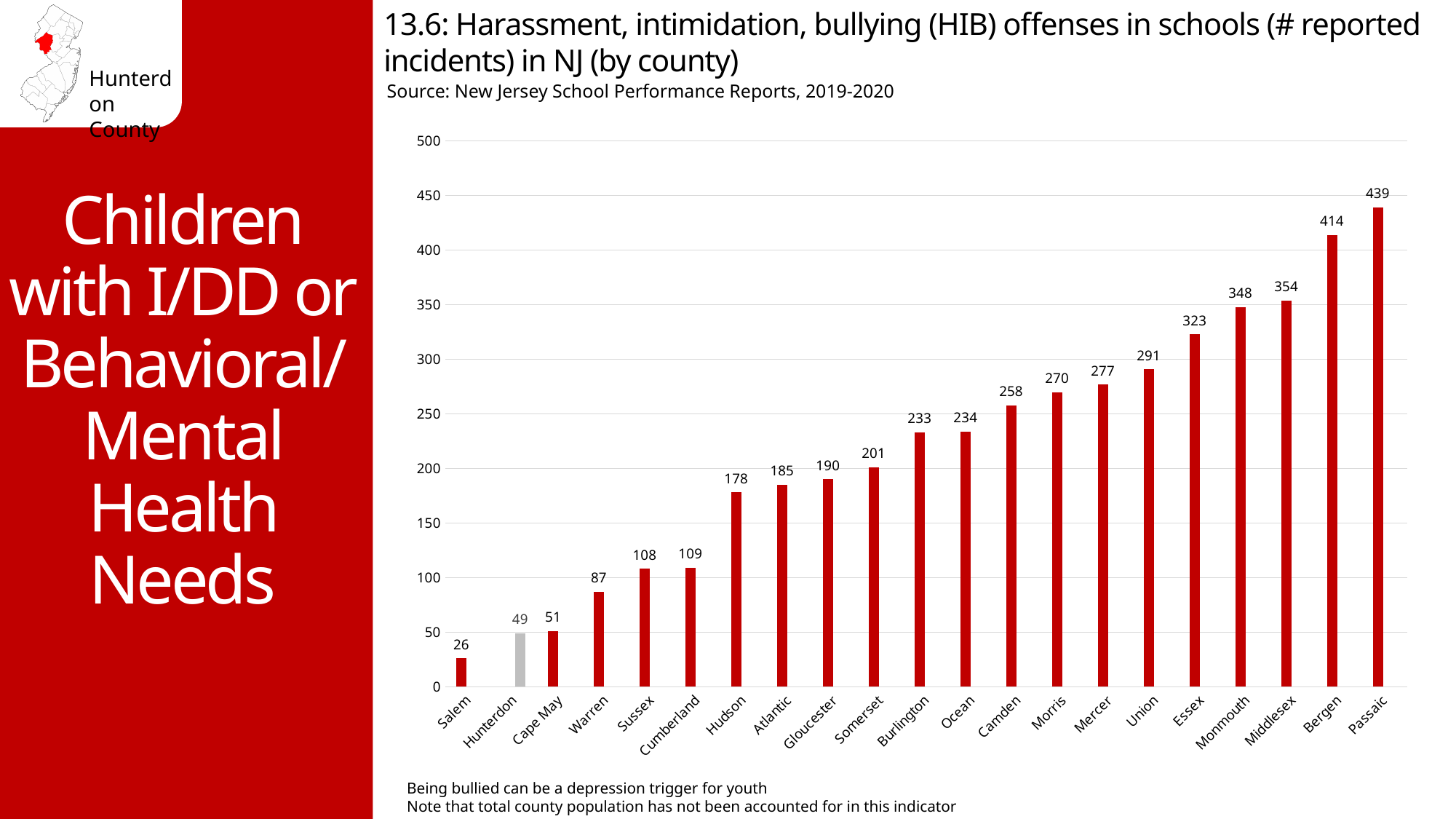
Do the values rise or fall moving from left to right along the x axis? Rise What is the difference between the values for Passaic and Salem? 413 What is the value shown for Gloucester? 190 Is the value for Monmouth greater or less than 300? greater How many counties are shown on the x axis? 21 What is the value shown for Bergen? 414 Which county has the highest number of reported HIB incidents? Passaic How many reported HIB incidents does the chart show for Hunterdon? 49 What is the difference between the values for Hunterdon and Cape May? 2 Which has a higher value, Essex or Union? Essex Which county has the lowest number of reported HIB incidents? Salem What kind of chart is shown on the slide? Bar chart